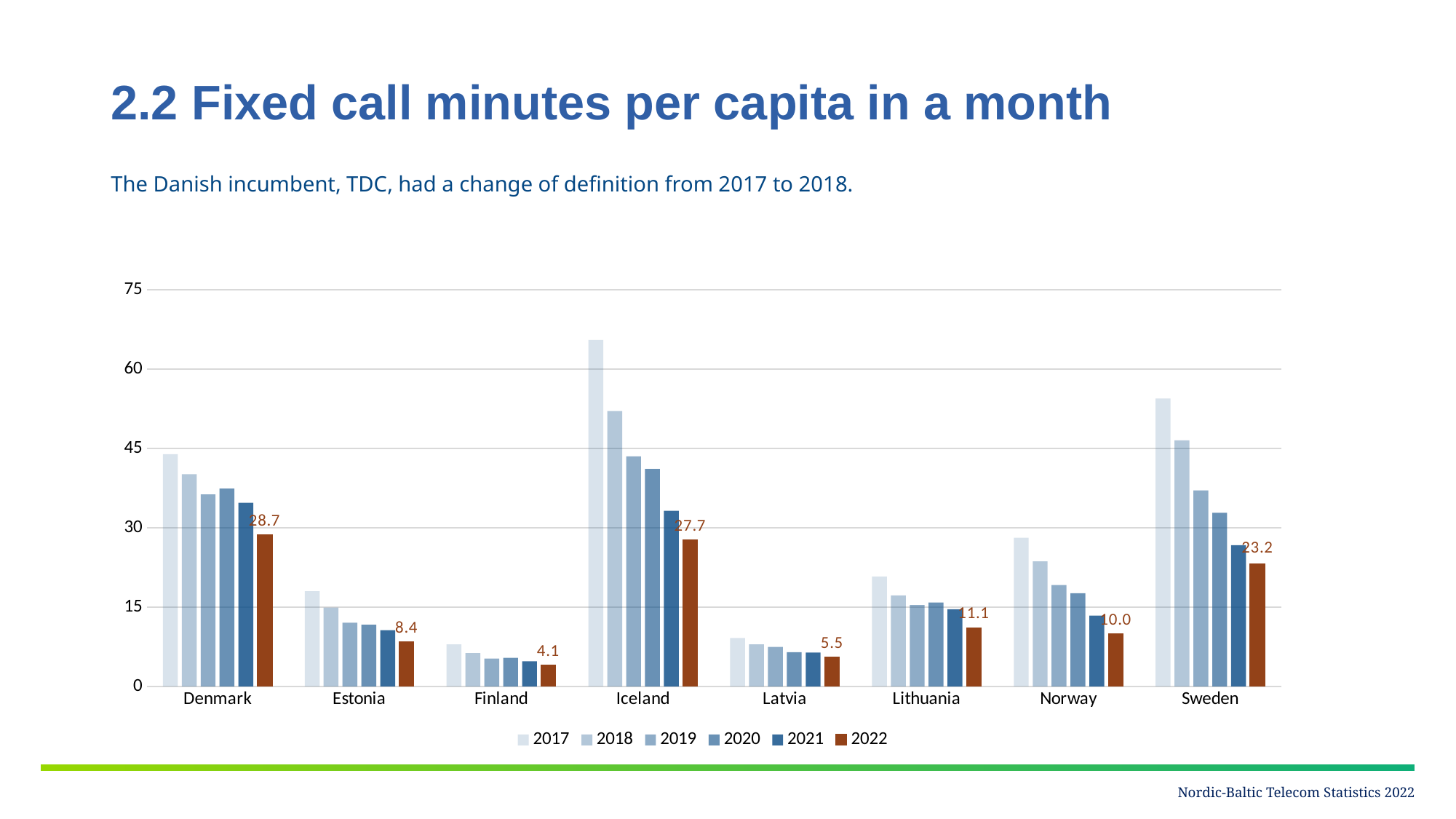
Which is larger, the 2022 value for Lithuania or the 2022 value for Norway? Lithuania What is the 2022 value for Denmark? 28.7 Which country has the highest 2022 value? Denmark Is the 2017 value for Iceland greater or less than 60? greater Do the values for Iceland rise or fall from 2017 to 2022? fall Is the 2017 value for Sweden greater or less than 45? greater What is the 2022 value for Sweden? 23.2 Which country has the lowest 2022 value? Finland What is the 2022 value for Finland? 4.1 How many countries are shown on the x axis? 8 What is the difference between the 2022 values for Denmark and Iceland? 1.0 How many series does the legend list? 6